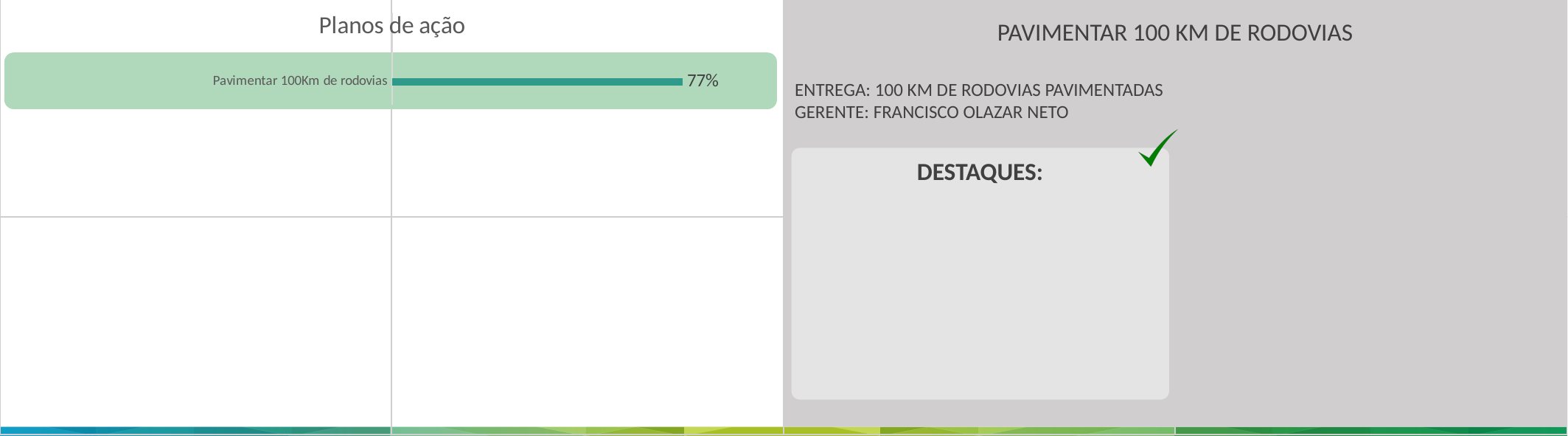
How many categories are plotted in the Planos de ação chart? 1 What kind of chart is shown under the title "Planos de ação"? bar chart What is the title of the chart on the left side of the slide? Planos de ação Is the value for "Pavimentar 100Km de rodovias" in the Planos de ação chart greater or less than 100%? less What is the value shown for "Pavimentar 100Km de rodovias" in the Planos de ação chart? 77% Is the value for "Pavimentar 100Km de rodovias" in the Planos de ação chart greater or less than 50%? greater What is the label of the only bar in the Planos de ação chart? Pavimentar 100Km de rodovias